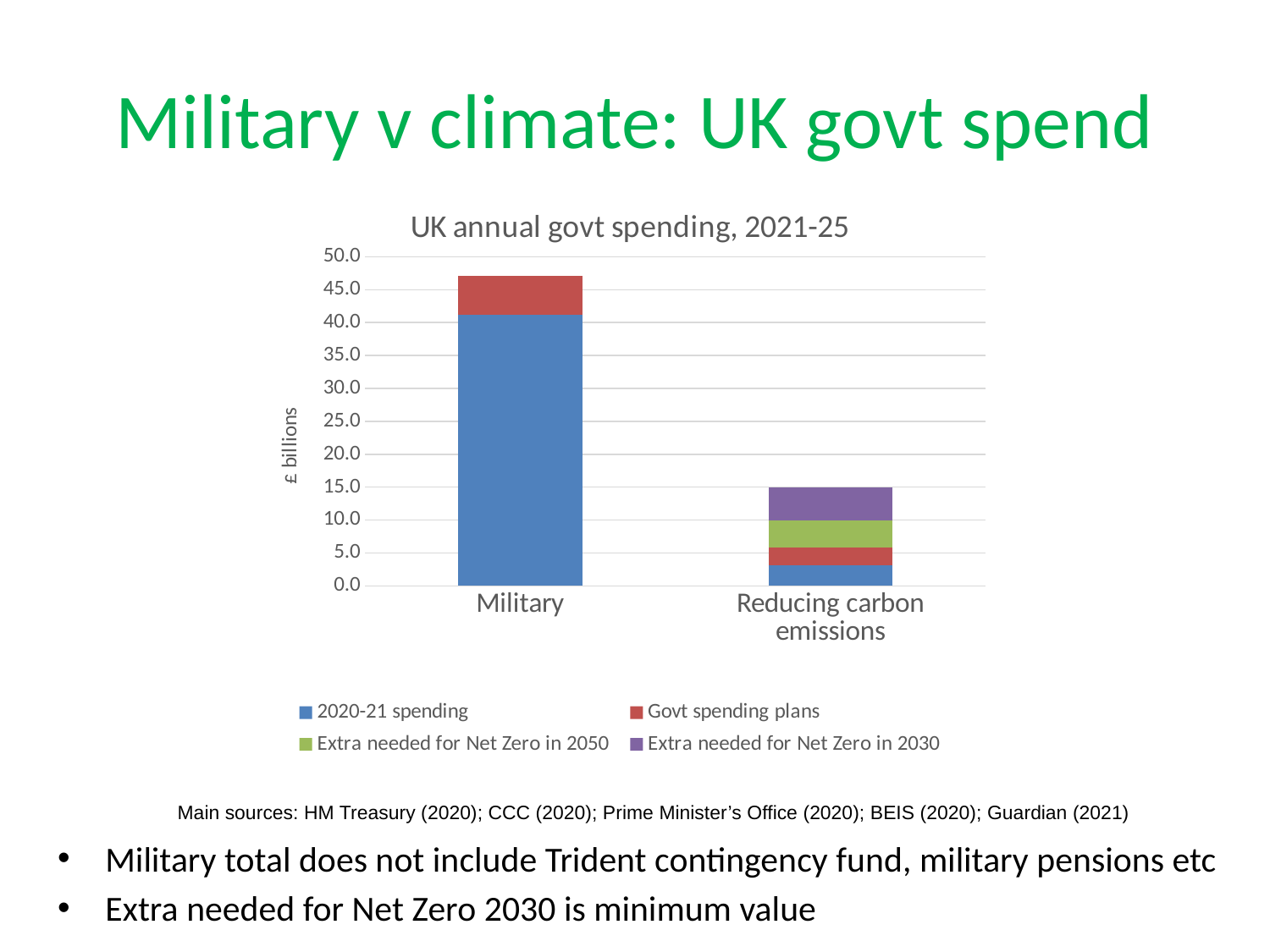
What is the label on the chart's vertical axis? £ billions How many series does the chart's legend list? 4 What type of chart is shown on the slide? Stacked bar chart Is the total value for Military greater or less than 40.0? greater Is the 2020-21 spending value for Military greater or less than 35.0? greater Which category has the lowest total bar? Reducing carbon emissions What is the title of the chart? UK annual govt spending, 2021-25 Which has the larger total bar, Military or Reducing carbon emissions? Military How many categories are shown on the x axis of the chart? 2 Is the 2020-21 spending value for Reducing carbon emissions greater or less than 5.0? less Which category has the highest total bar? Military